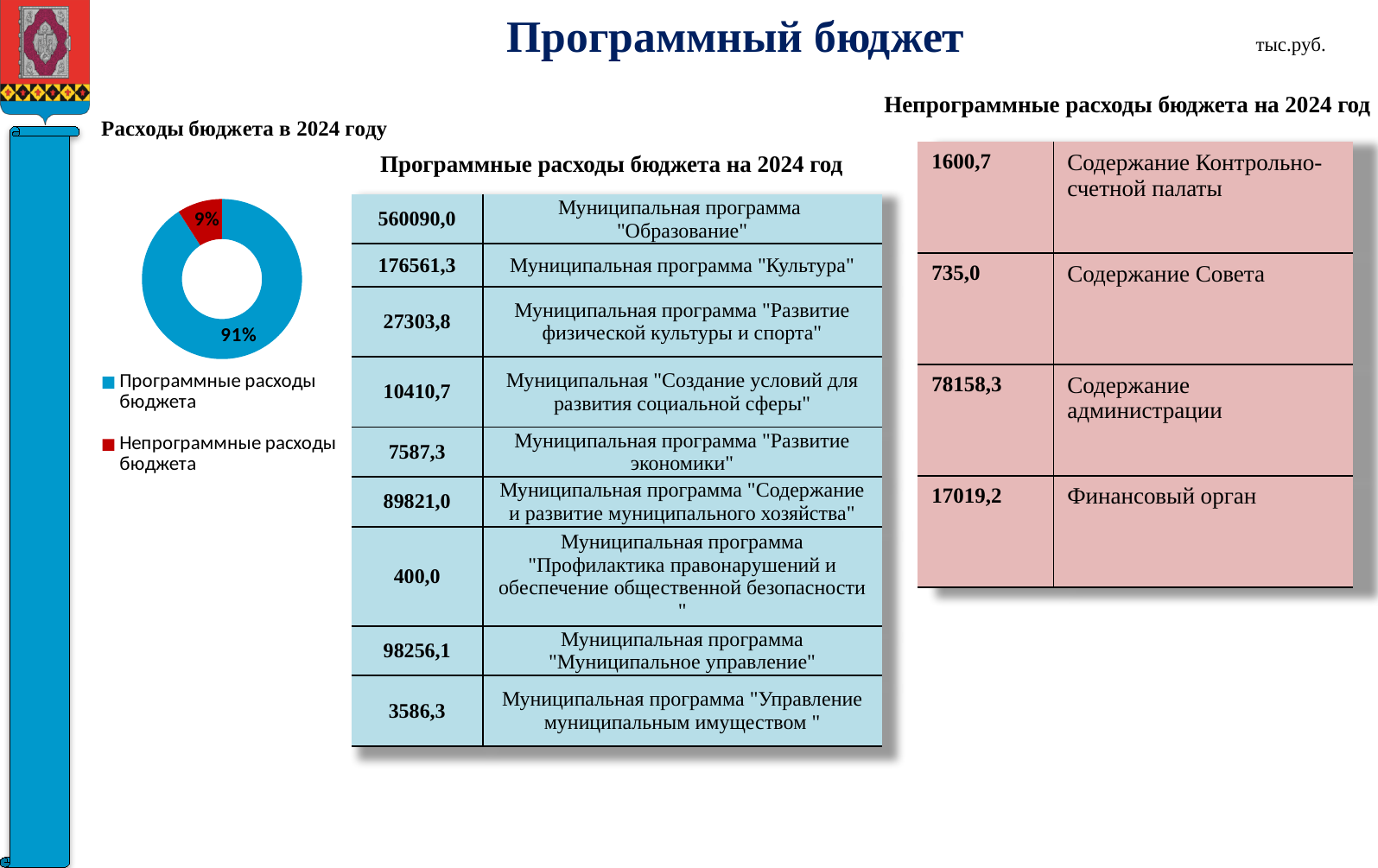
What is the title of the chart on the left of the slide? Расходы бюджета в 2024 году In the pie chart 'Расходы бюджета в 2024 году', what is the difference in percentage points between 'Программные расходы бюджета' and 'Непрограммные расходы бюджета'? 82% What share of the pie chart 'Расходы бюджета в 2024 году' is 'Непрограммные расходы бюджета'? 9% What is the value printed on the blue slice of the pie chart 'Расходы бюджета в 2024 году'? 91% What kind of chart is 'Расходы бюджета в 2024 году'? doughnut chart What colour is the 'Непрограммные расходы бюджета' slice in the pie chart 'Расходы бюджета в 2024 году'? red Which category has the largest slice in the pie chart 'Расходы бюджета в 2024 году'? Программные расходы бюджета What share of the pie chart 'Расходы бюджета в 2024 году' is 'Программные расходы бюджета'? 91% How many entries does the legend of the pie chart 'Расходы бюджета в 2024 году' list? 2 Which category has the smallest slice in the pie chart 'Расходы бюджета в 2024 году'? Непрограммные расходы бюджета In the pie chart 'Расходы бюджета в 2024 году', which is larger: 'Программные расходы бюджета' or 'Непрограммные расходы бюджета'? Программные расходы бюджета How many slices does the pie chart 'Расходы бюджета в 2024 году' have? 2